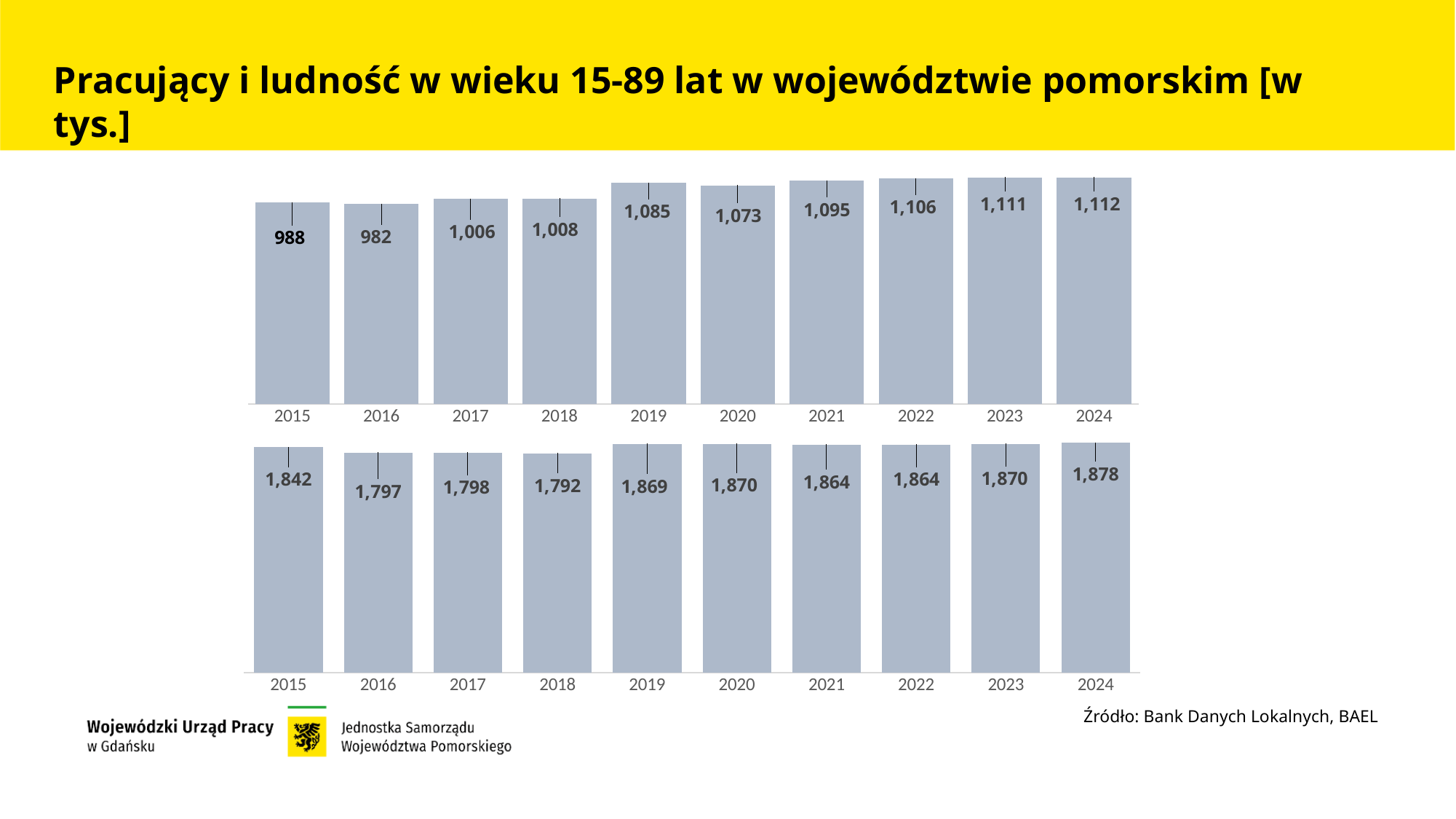
In the top chart, what is the value for 2020? 1,073 In the top chart, which year has the lowest value? 2016 In the top chart, which year has the highest value? 2024 In the bottom chart, what is the value for 2024? 1,878 What kind of chart is the top chart? bar chart In the bottom chart, what is the difference between the values for 2019 and 2016? 72 In the bottom chart, what is the value for 2018? 1,792 In the top chart, which is larger: the value for 2019 or the value for 2020? 2019 In the top chart, what is the value for 2015? 988 In the top chart, what is the difference between the values for 2024 and 2015? 124 In the bottom chart, which year has the lowest value? 2018 How many years are shown on the x axis of the bottom chart? 10